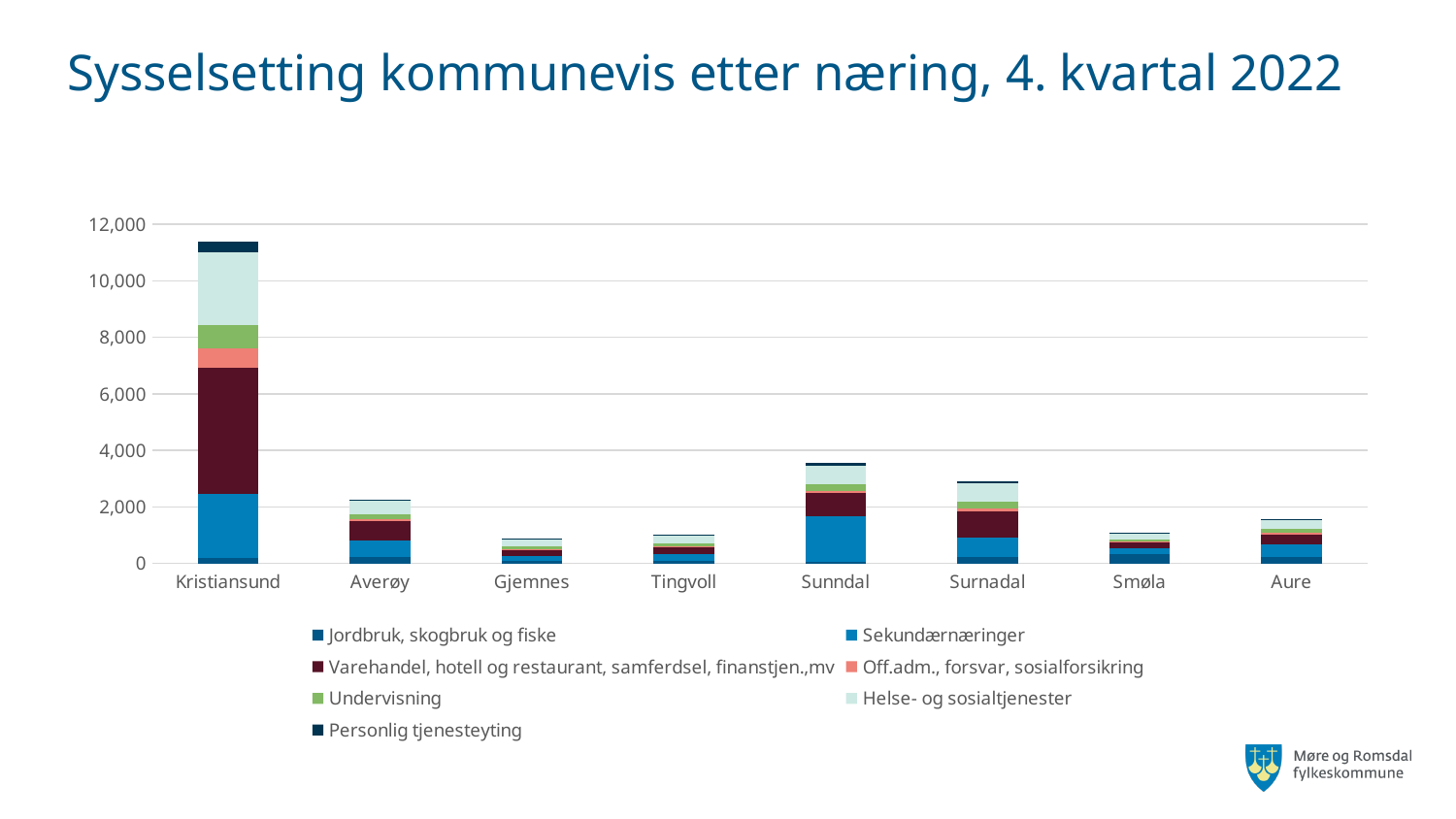
Which series is listed last in the legend? Personlig tjenesteyting Which municipality has the highest total employment? Kristiansund Is the total value for Gjemnes greater or less than 2,000? less What kind of chart is shown on the slide? Stacked bar chart Which has the larger total, Aure or Smøla? Aure Is the total value for Kristiansund greater or less than 10,000? greater What is the title of the chart? Sysselsetting kommunevis etter næring, 4. kvartal 2022 Is the total value for Sunndal greater or less than 4,000? less How many municipalities are shown on the x axis? 8 How many series does the legend list? 7 Which has the larger total, Sunndal or Surnadal? Sunndal